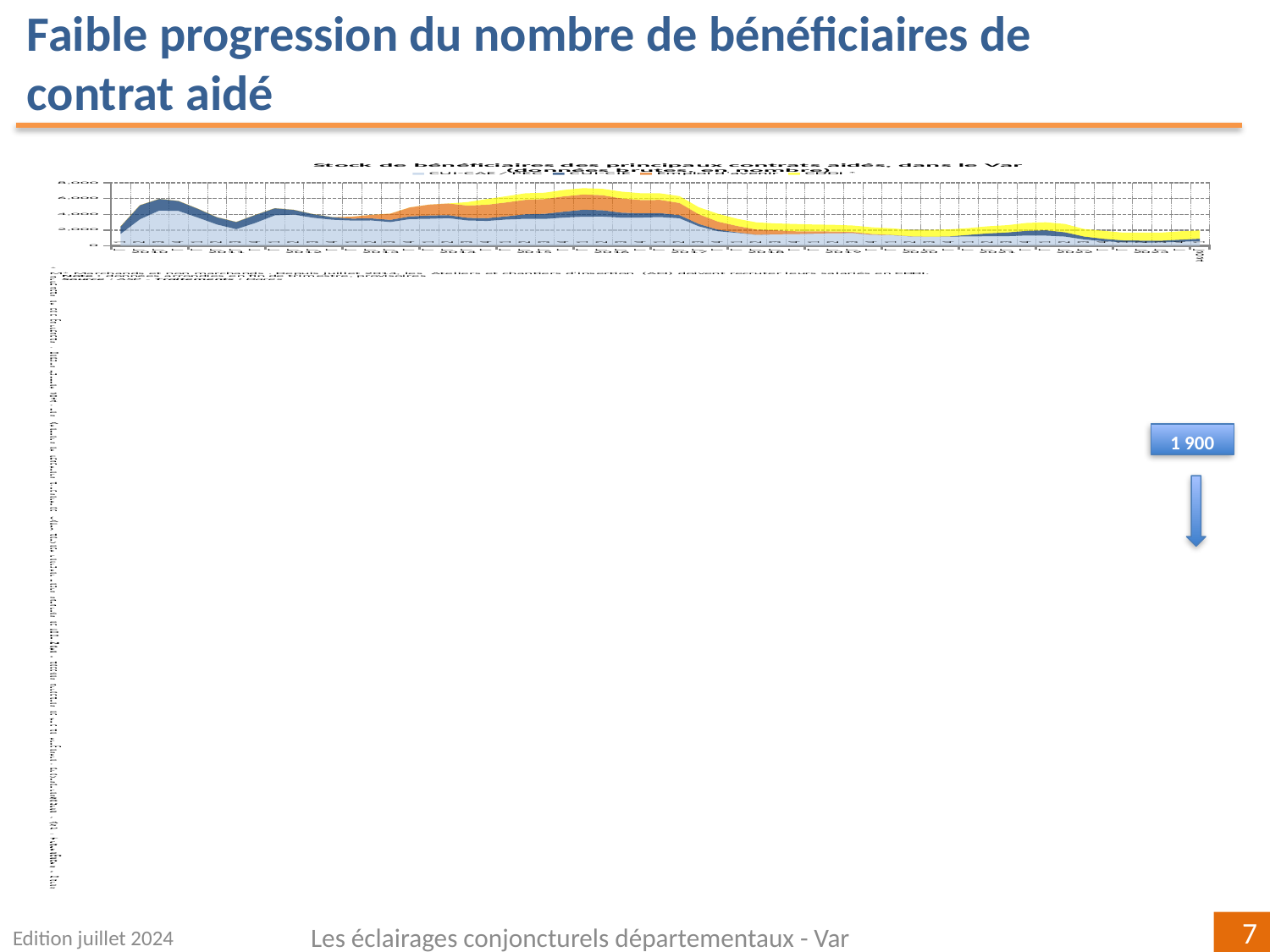
What is the title of the chart? Stock de bénéficiaires des principaux contrats aidés, dans le Var (données brutes, en nombre) Is the total stock of beneficiaries larger in 2016 or in 2022? 2016 What kind of chart is shown on the slide? stacked area chart How many series does the chart legend list? 4 Is the total stock of beneficiaries in 2019 greater or less than 4,000? less Which year is the first one labelled on the chart's horizontal axis? 2010 Which year is the last one labelled on the chart's horizontal axis? 2024 What value is shown in the blue callout box next to the chart? 1 900 What is the highest value shown on the chart's vertical axis? 8,000 Is the total stock of beneficiaries in 2023 greater or less than 2,000? less Is the total stock of beneficiaries in 2016 greater or less than 4,000? greater Does the total stock of beneficiaries rise or fall between 2016 and 2023? fall